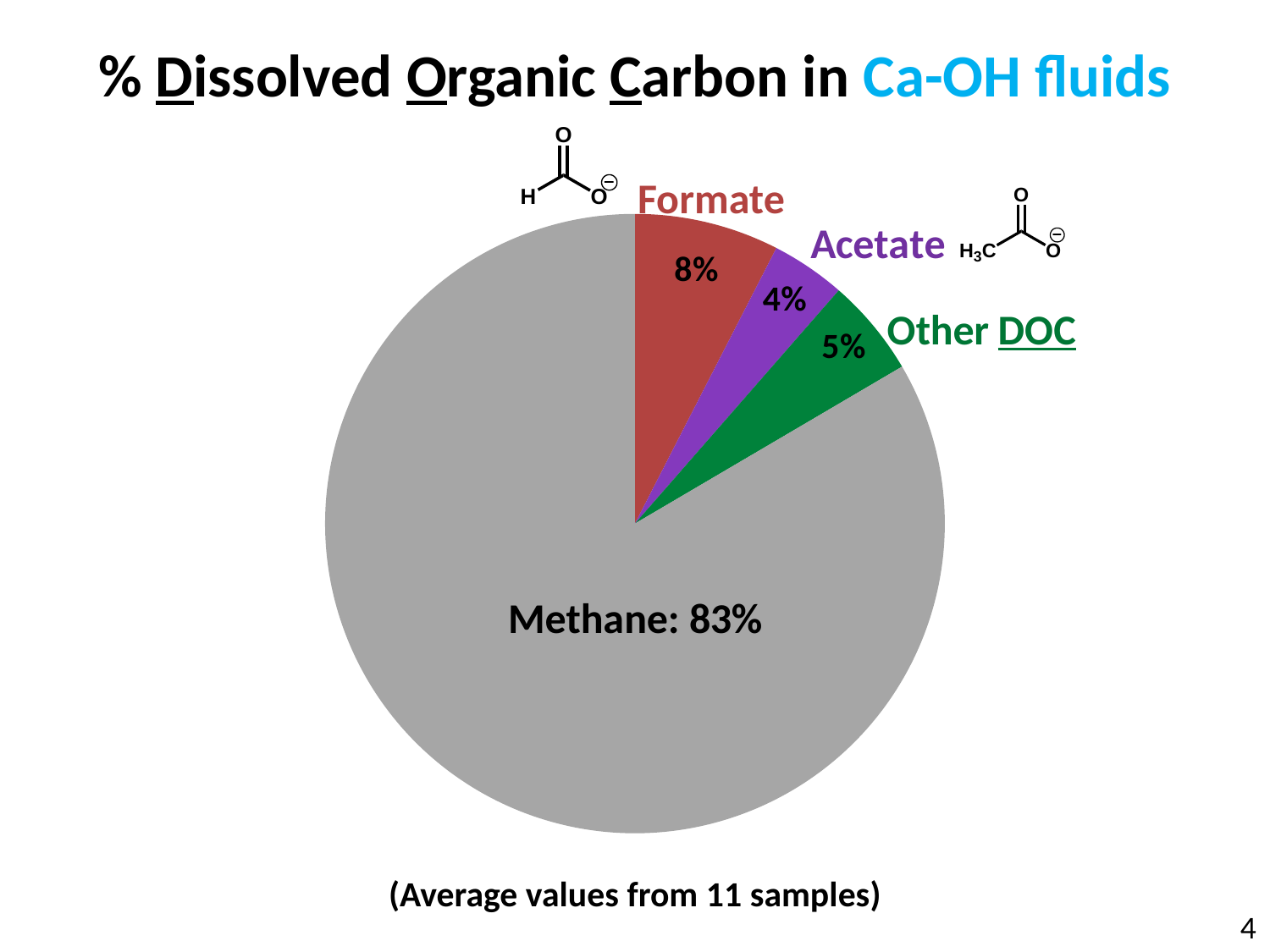
Which category has the smallest slice of the pie? Acetate How many slices does the pie chart have? 4 What colour is the methane slice? Grey What percentage does acetate account for? 4% What type of chart is shown on the slide? Pie chart What is the difference in percentage points between formate and acetate? 4 What is the value shown for Other DOC? 5% Which category has the largest slice of the pie? Methane Which is larger, the formate slice or the Other DOC slice? Formate What percentage of dissolved organic carbon in Ca-OH fluids is methane? 83% According to the note below the chart, how many samples were averaged? 11 What share of the pie is formate? 8%